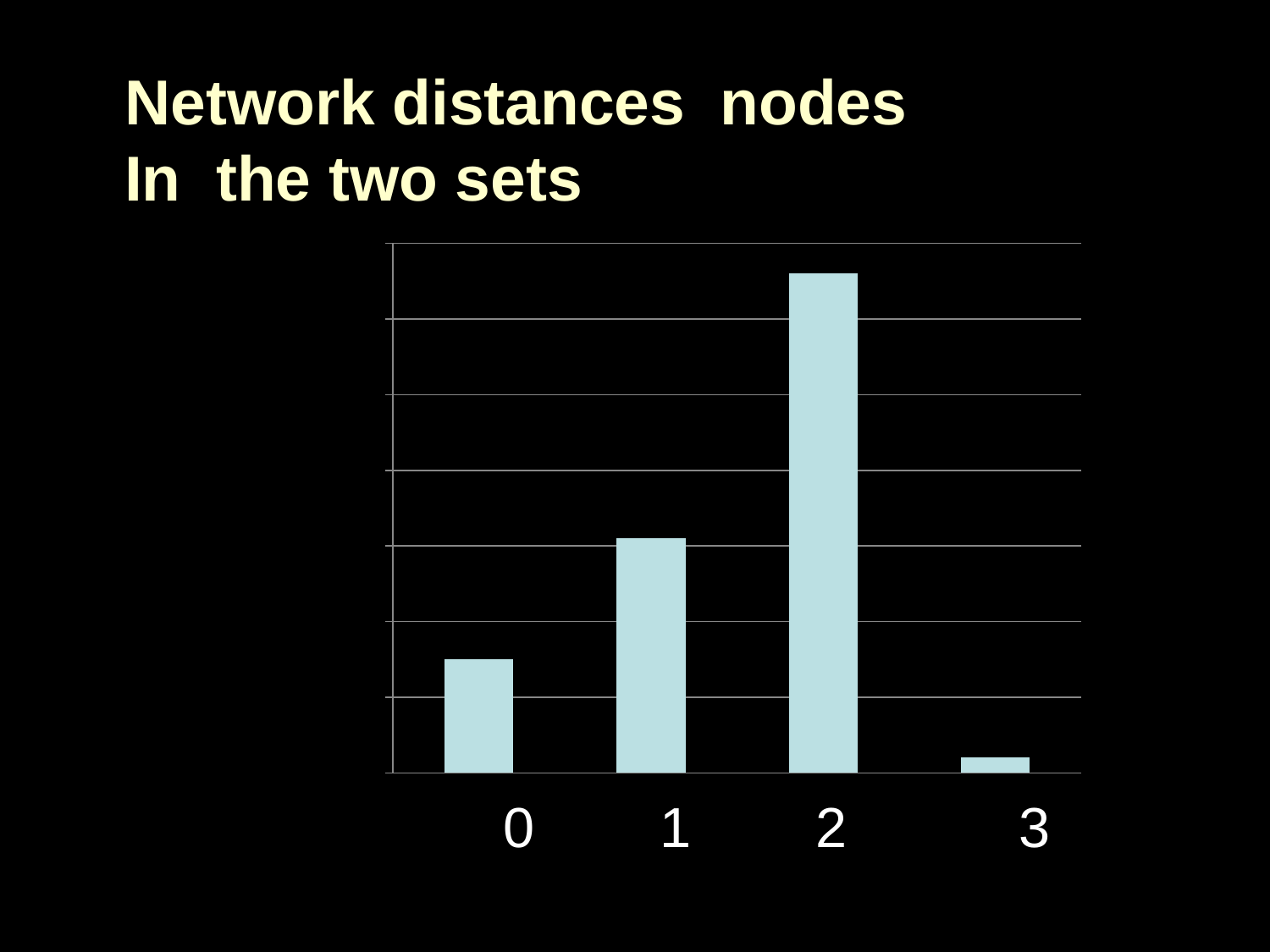
How many categories are shown on the x axis of the chart? 4 Do the bar values rise or fall going from category 0 to category 2? rise Which category has the larger value, 2 or 3? 2 Do the bar values rise or fall going from category 2 to category 3? fall What kind of chart is shown on the slide? bar chart What are the category labels on the x axis of the chart? 0, 1, 2, 3 Which category has the highest bar in the chart? 2 Which category has the lowest bar in the chart? 3 Which category has the larger value, 0 or 3? 0 Which category has the larger value, 1 or 2? 2 What colour are the bars in the chart? light blue